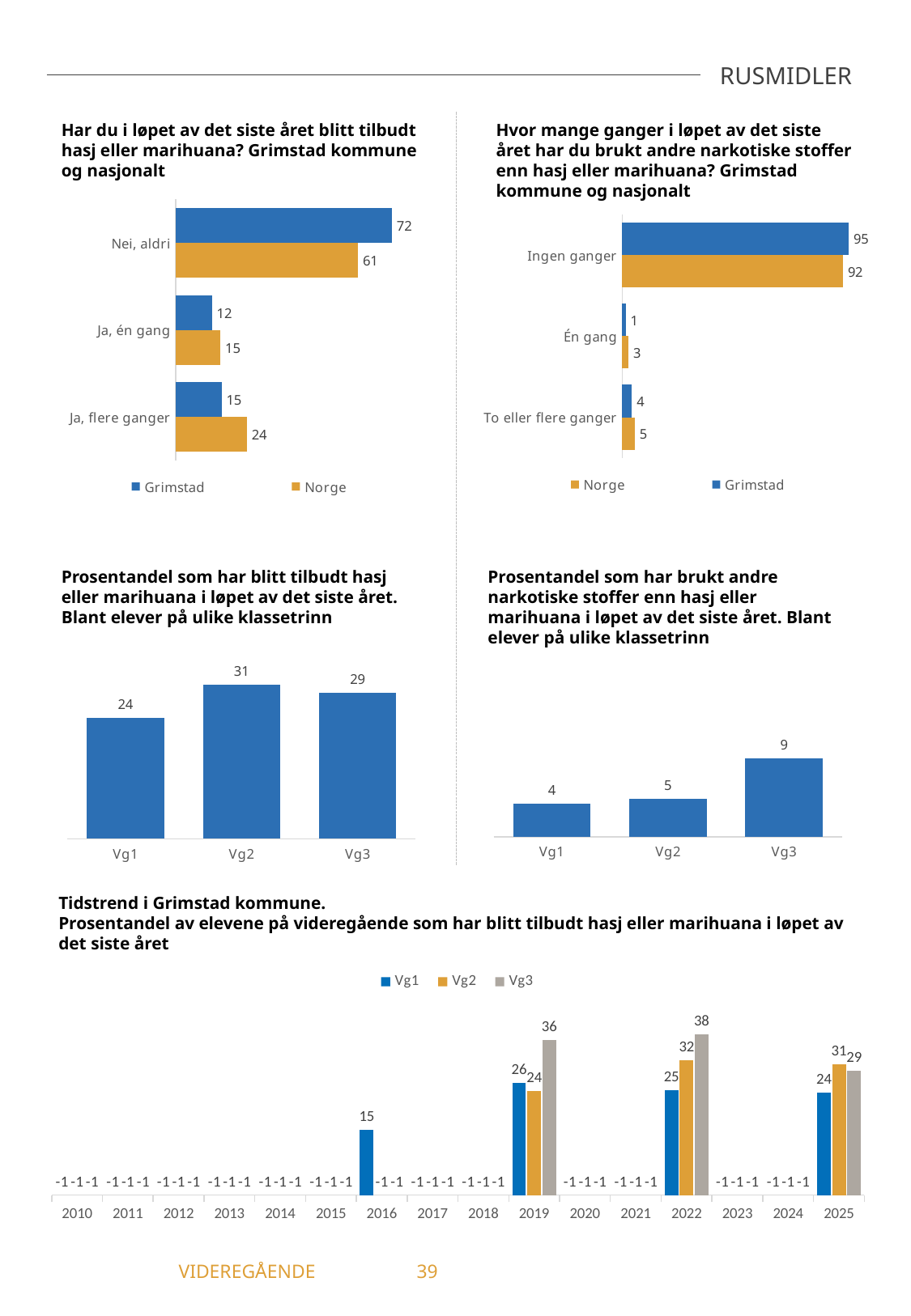
In the top-right chart 'Hvor mange ganger i løpet av det siste året har du brukt andre narkotiske stoffer enn hasj eller marihuana?', what is the Grimstad value for 'Én gang'? 1 In the middle-left chart 'Prosentandel som har blitt tilbudt hasj eller marihuana i løpet av det siste året', which class level has the highest value? Vg2 In the top-left chart 'Har du i løpet av det siste året blitt tilbudt hasj eller marihuana?', what is the value for Grimstad in the 'Nei, aldri' category? 72 How many series does the legend list in the top-right chart 'Hvor mange ganger i løpet av det siste året har du brukt andre narkotiske stoffer enn hasj eller marihuana?'? 2 In the top-left chart 'Har du i løpet av det siste året blitt tilbudt hasj eller marihuana?', what is the difference between the Norge and Grimstad values for 'Ja, flere ganger'? 9 In the top-left chart 'Har du i løpet av det siste året blitt tilbudt hasj eller marihuana?', which is larger for 'Ja, én gang': Grimstad or Norge? Norge In the middle-right chart 'Prosentandel som har brukt andre narkotiske stoffer enn hasj eller marihuana', what is the value for Vg3? 9 In the middle-right chart 'Prosentandel som har brukt andre narkotiske stoffer enn hasj eller marihuana', do the values rise or fall from Vg1 to Vg3? rise In the middle-left chart 'Prosentandel som har blitt tilbudt hasj eller marihuana i løpet av det siste året', what is the value for Vg1? 24 In the top-right chart 'Hvor mange ganger i løpet av det siste året har du brukt andre narkotiske stoffer enn hasj eller marihuana?', what is the value for Norge in the 'Ingen ganger' category? 92 What kind of chart is the bottom chart 'Tidstrend i Grimstad kommune'? bar chart In the bottom chart 'Tidstrend i Grimstad kommune', what is the value for Vg3 in 2022? 38